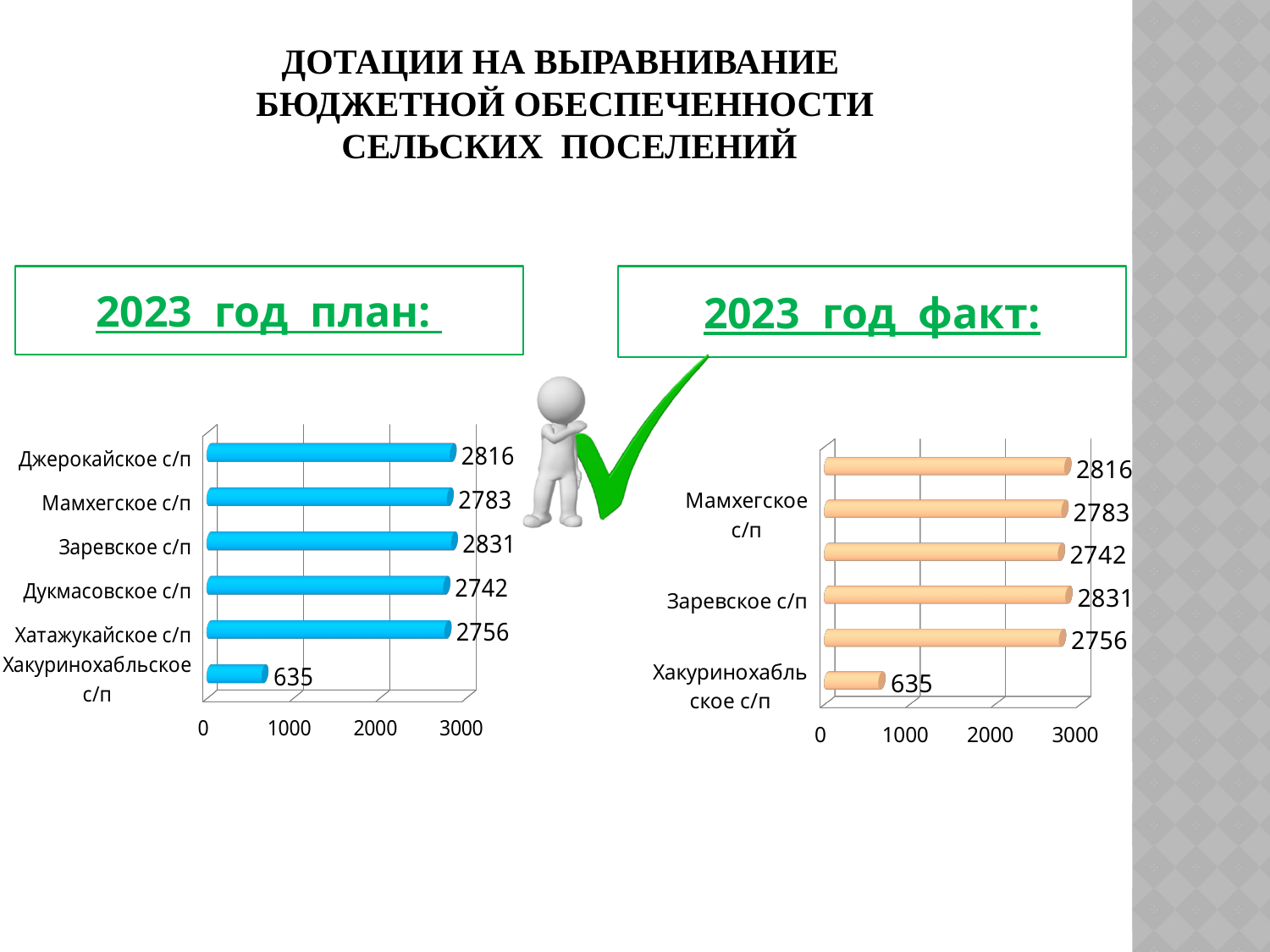
In the '2023 год план' chart, what is the value for Дукмасовское с/п? 2742 In the '2023 год план' chart, which is larger: the value for Мамхегское с/п or for Хатажукайское с/п? Мамхегское с/п In the '2023 год план' chart, which category has the lowest value? Хакуринохабльское с/п In the '2023 год план' chart, what is the value for Джерокайское с/п? 2816 In the '2023 год факт' chart on the right, what is the value for Хакуринохабльское с/п? 635 In the '2023 год факт' chart on the right, is the value for Мамхегское с/п greater or less than 2000? greater In the '2023 год план' chart, what is the difference between the values for Заревское с/п and Хакуринохабльское с/п? 2196 How many categories are shown in the '2023 год план' chart? 6 What kind of chart is the '2023 год план' chart on the left? bar chart In the '2023 год план' chart, which category has the highest value? Заревское с/п In the '2023 год факт' chart on the right, what is the value for Заревское с/п? 2831 What colour are the bars in the '2023 год план' chart on the left? blue